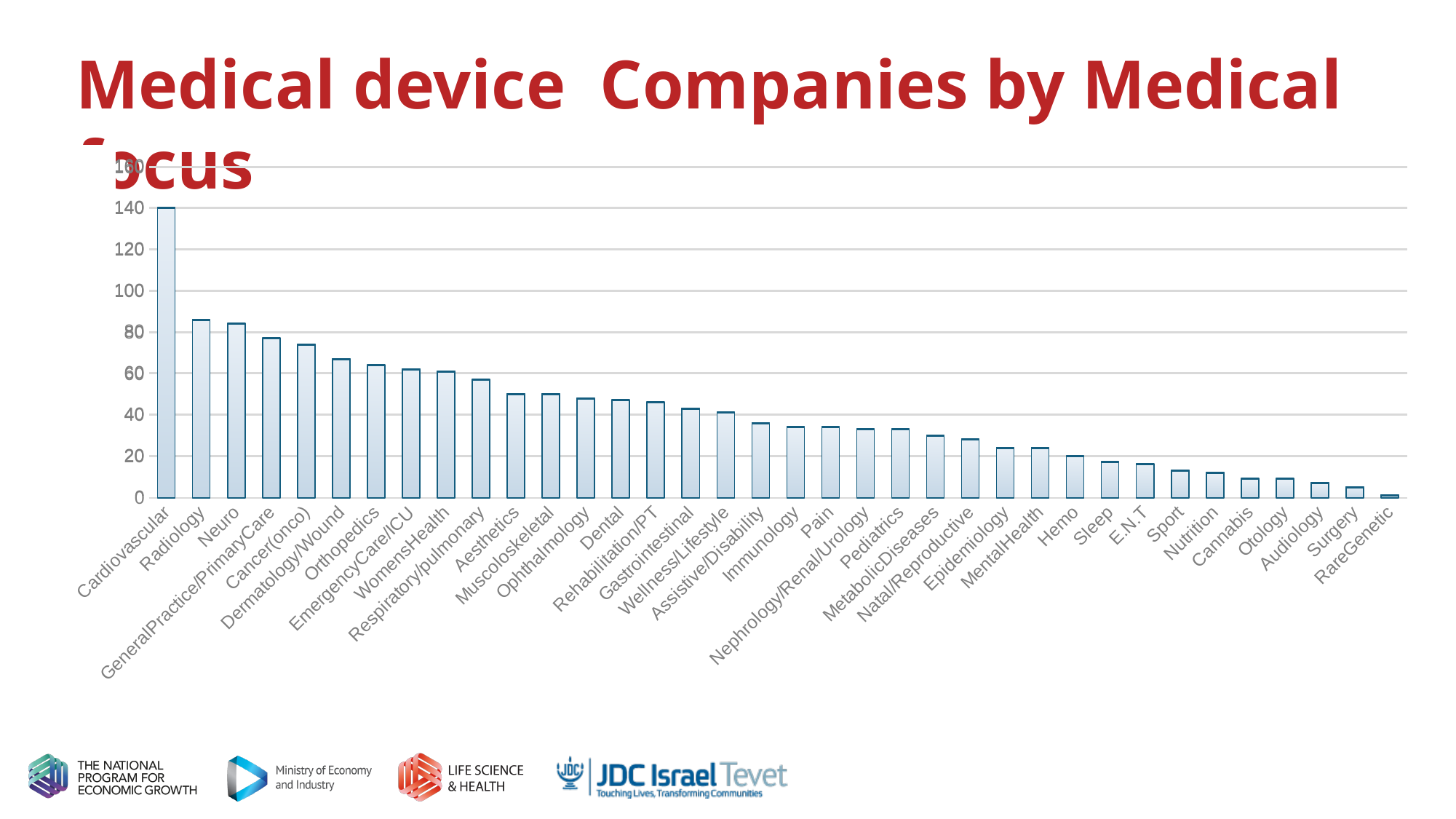
Is the value for Radiology greater or less than 80? greater Do the values rise or fall moving from left to right along the x axis? fall Which has more medical device companies, Surgery or Pediatrics? Pediatrics What is the title of the slide containing the chart? Medical device Companies by Medical focus Is the value for Dental greater or less than 60? less Which has more medical device companies, Neuro or Orthopedics? Neuro Is the value for Cardiovascular greater or less than 120? greater What kind of chart is shown on the slide? bar chart How many medical focus categories are shown on the x axis? 36 Which medical focus has the highest number of medical device companies? Cardiovascular Which medical focus has the lowest number of medical device companies? RareGenetic